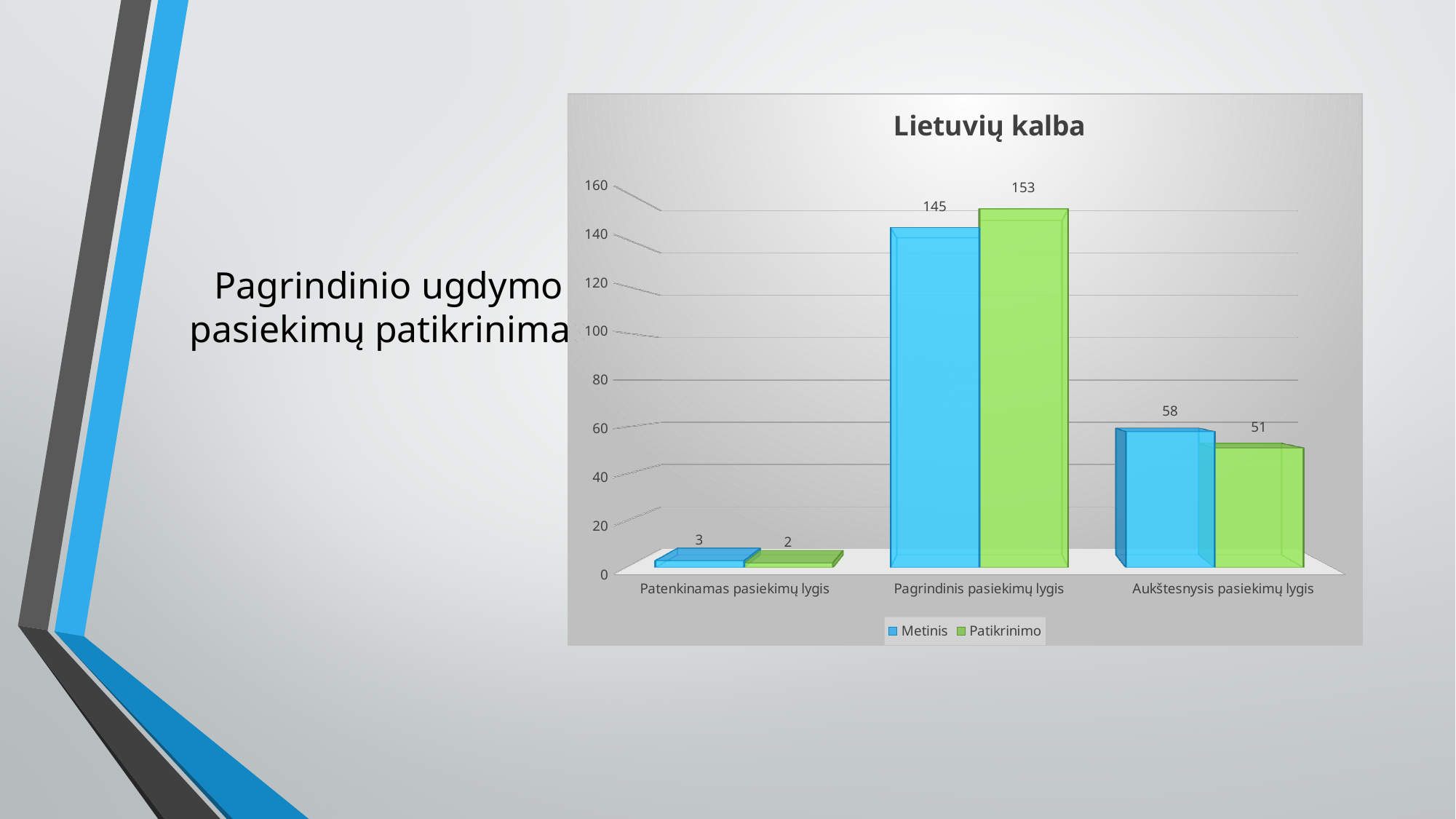
Which category has the highest Patikrinimo value? Pagrindinis pasiekimų lygis What is the title of the chart? Lietuvių kalba How many categories are shown on the x axis? 3 What is the Patikrinimo value for Aukštesnysis pasiekimų lygis? 51 For Aukštesnysis pasiekimų lygis, which series has the larger value, Metinis or Patikrinimo? Metinis What is the difference between the Metinis and Patikrinimo values for Aukštesnysis pasiekimų lygis? 7 What is the Patikrinimo value for Patenkinamas pasiekimų lygis? 2 How many series does the legend list? 2 What is the difference between the Patikrinimo and Metinis values for Pagrindinis pasiekimų lygis? 8 Which category has the lowest Metinis value? Patenkinamas pasiekimų lygis Is the Metinis value for Pagrindinis pasiekimų lygis greater or less than 100? greater What is the Metinis value for Pagrindinis pasiekimų lygis? 145